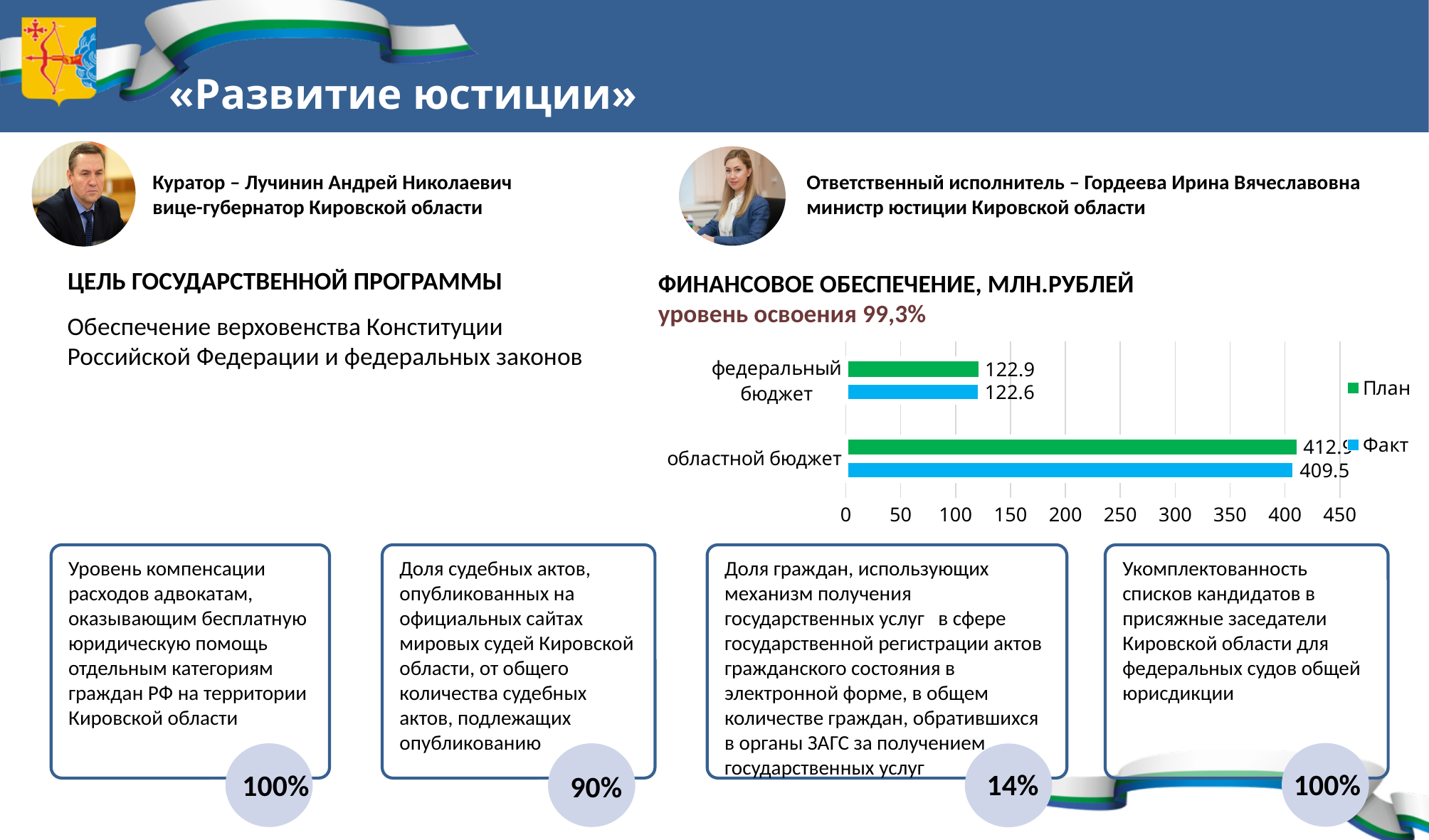
Which category has the higher Факт value, федеральный бюджет or областной бюджет? областной бюджет Is the План value for областной бюджет greater or less than 400? greater What is the План value for федеральный бюджет? 122.9 What colour represents the Факт series on the financial chart? light blue What is the Факт value for областной бюджет? 409.5 Which category has the lowest Факт value on the financial chart? федеральный бюджет What type of chart is shown under «ФИНАНСОВОЕ ОБЕСПЕЧЕНИЕ, МЛН.РУБЛЕЙ»? bar chart What is the Факт value for федеральный бюджет? 122.6 How many series does the legend of the financial chart list? 2 How many budget categories are shown on the financial chart? 2 What are the two series named in the legend of the financial chart? План and Факт What is the difference between the План and Факт values for федеральный бюджет? 0.3